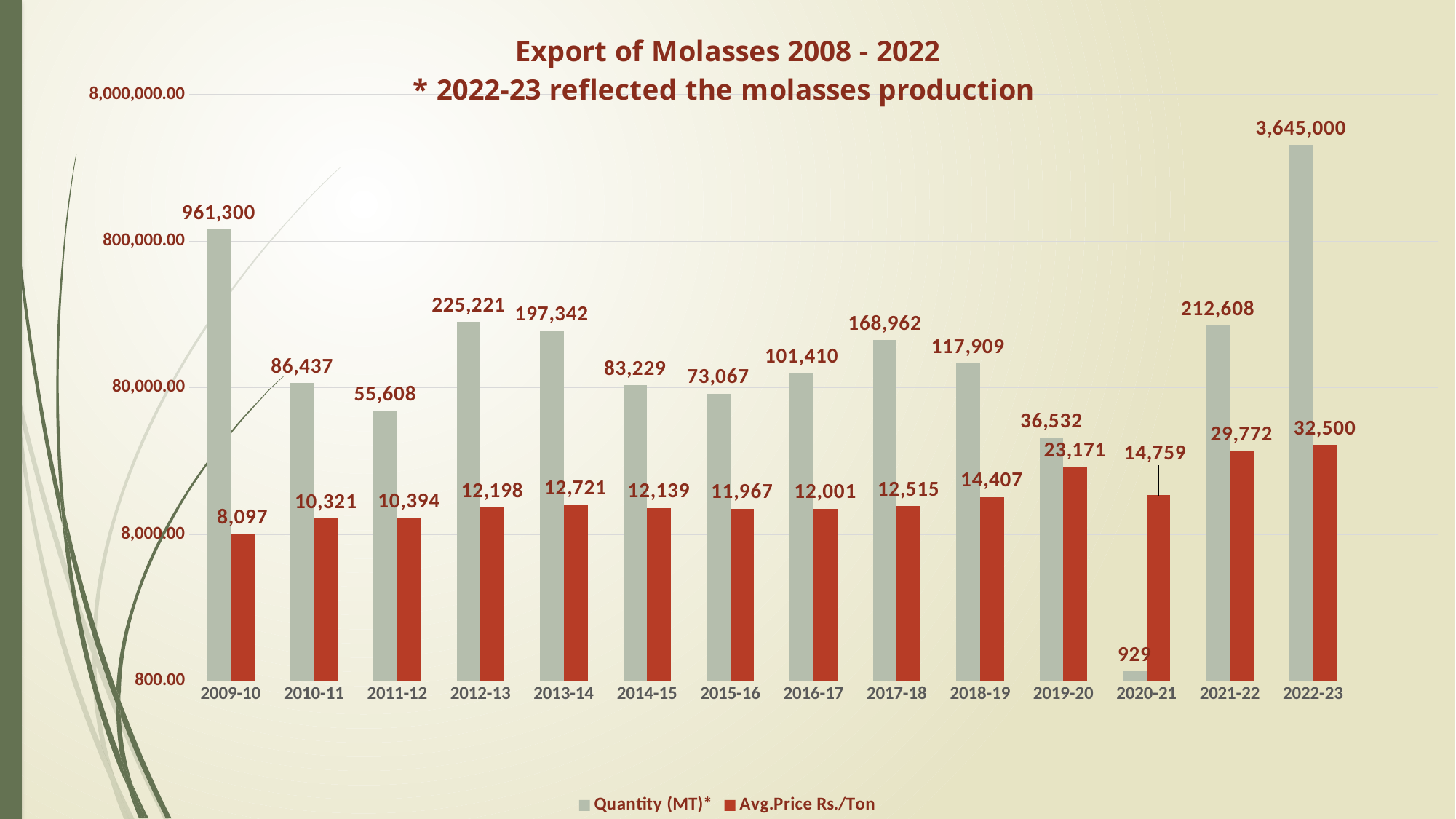
How many years are shown on the x axis? 14 How many series does the legend list? 2 What is the Quantity (MT)* value for 2012-13? 225,221 Which year has the lowest Avg.Price Rs./Ton value? 2009-10 What is the first line of the chart title? Export of Molasses 2008 - 2022 Which year has the larger Quantity (MT)* value, 2017-18 or 2018-19? 2017-18 What is the Avg.Price Rs./Ton value for 2019-20? 23,171 What is the difference between the Quantity (MT)* values for 2012-13 and 2013-14? 27,879 Which year has the lowest Quantity (MT)* value? 2020-21 Which year has the highest Quantity (MT)* value? 2022-23 What kind of chart is shown on the slide? Bar chart What is the difference between the Avg.Price Rs./Ton values for 2021-22 and 2020-21? 15,013